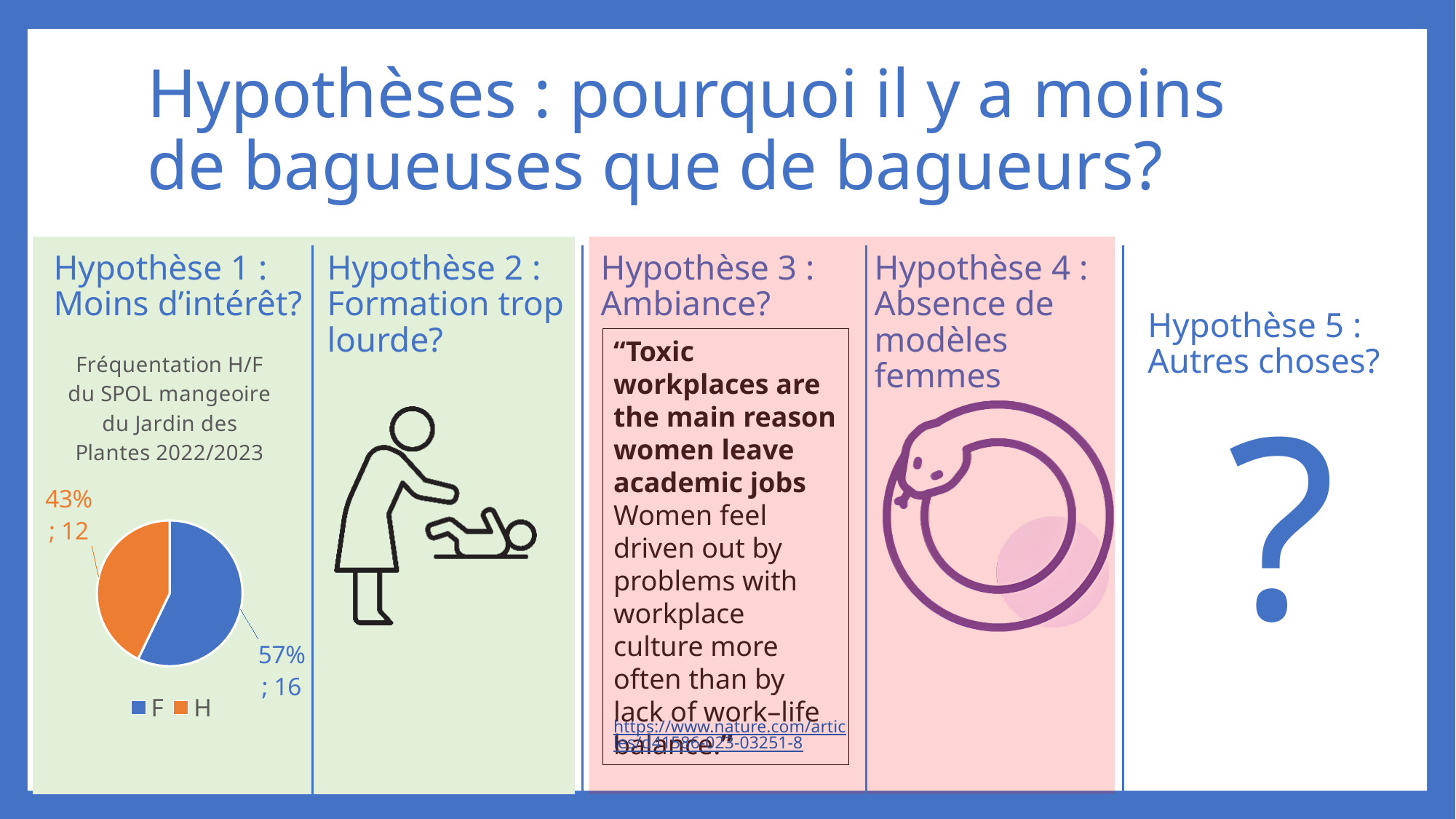
What is the count shown for the F slice of the pie chart? 16 Which colour represents H in the pie chart? orange What is the title of the pie chart on the slide? Fréquentation H/F du SPOL mangeoire du Jardin des Plantes 2022/2023 What percentage of the pie chart does the H slice represent? 43% Which slice of the pie chart is the smallest? H What is the count shown for the H slice of the pie chart? 12 What is the difference between the counts for F and H in the pie chart? 4 What percentage of the pie chart does the F slice represent? 57% How many categories does the pie chart legend list? 2 What is the difference in percentage points between the F and H slices of the pie chart? 14 What kind of chart is shown under Hypothèse 1? pie chart Which slice of the pie chart is the largest? F